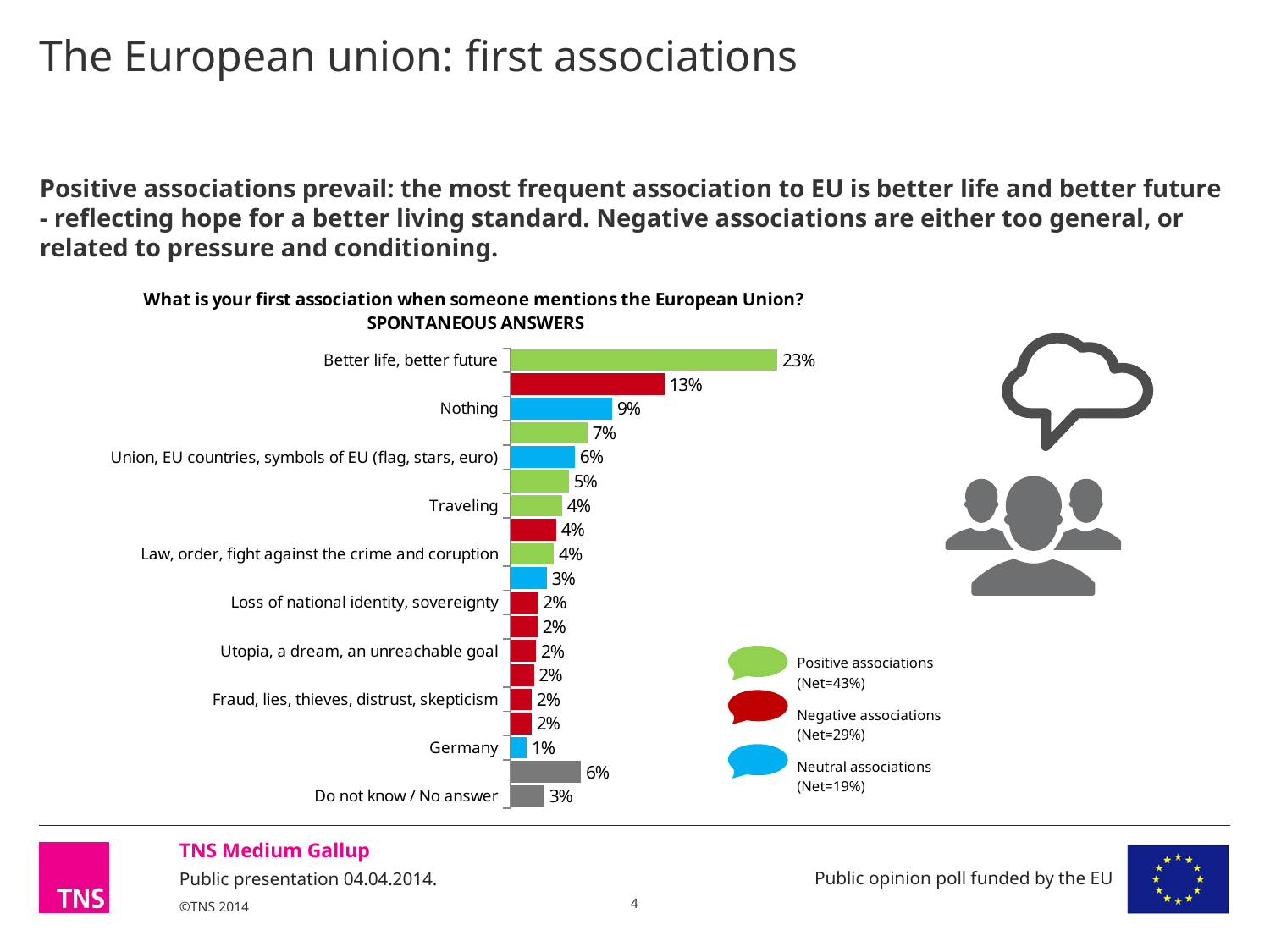
How many percentage points higher is "Better life, better future" than "Nothing"? 14 percentage points Which has a larger value: "Traveling" or "Germany"? Traveling What type of chart is used on this slide? Bar chart According to the legend, what is the net percentage for positive associations? 43% What percentage is shown for "Germany"? 1% Which labelled association has the lowest value in the chart? Germany How many categories does the legend list? 3 What is the value shown for "Nothing"? 9% What percentage is shown for "Union, EU countries, symbols of EU (flag, stars, euro)"? 6% Which labelled association has the highest value in the chart? Better life, better future What is the value for "Do not know / No answer"? 3% What percentage of respondents gave "Better life, better future" as their first association with the European Union? 23%